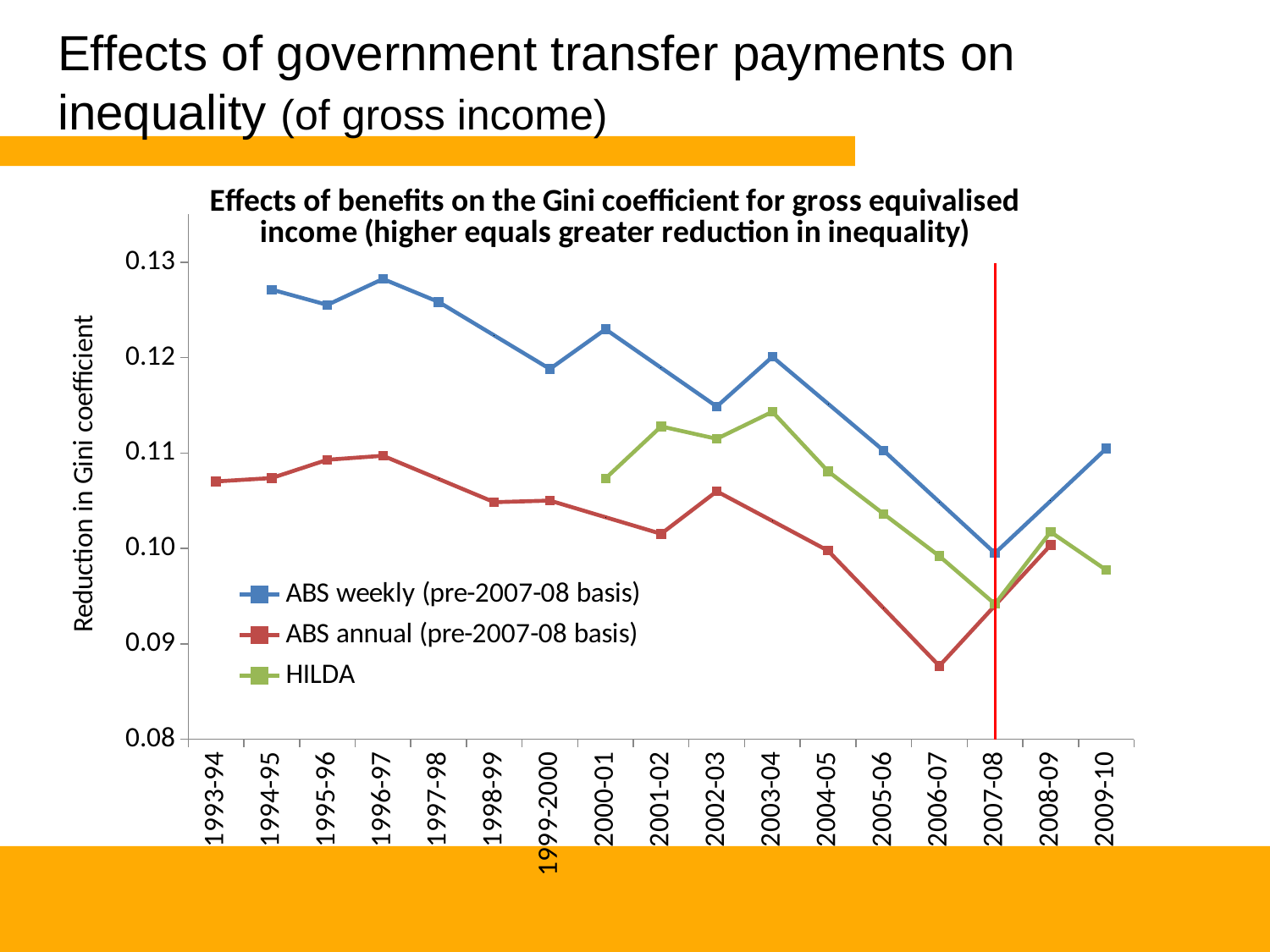
How many series does the legend list? 3 Is the HILDA value for 2003-04 greater or less than 0.11? greater In which year does the HILDA series reach its lowest value? 2007-08 What are the three series named in the legend? ABS weekly (pre-2007-08 basis), ABS annual (pre-2007-08 basis), HILDA In which year does the ABS annual (pre-2007-08 basis) series reach its lowest value? 2006-07 In 1994-95, which series has the higher value: ABS weekly (pre-2007-08 basis) or ABS annual (pre-2007-08 basis)? ABS weekly (pre-2007-08 basis) Is the ABS annual (pre-2007-08 basis) value for 2006-07 greater or less than 0.09? less Does the ABS annual (pre-2007-08 basis) series rise or fall between 2002-03 and 2006-07? fall What kind of chart is shown on the slide? line chart Is the ABS weekly (pre-2007-08 basis) value for 1996-97 greater or less than 0.12? greater In 2002-03, which series has the higher value: HILDA or ABS annual (pre-2007-08 basis)? HILDA How many year categories are shown on the x axis? 17